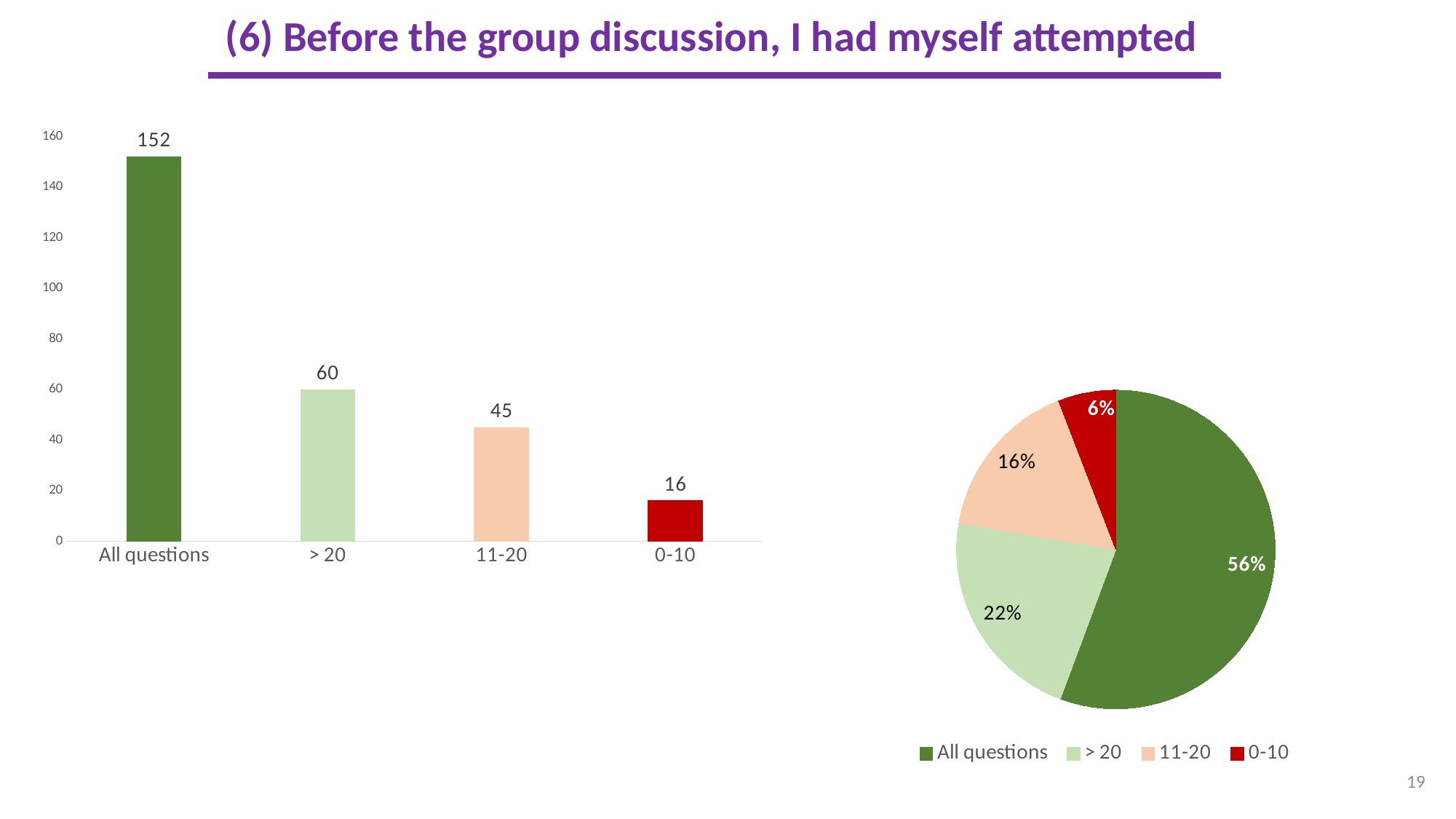
In the bar chart on the left, what is the difference between the values for '> 20' and '0-10'? 44 In the bar chart on the left, is the value for 'All questions' greater or less than 140? greater In the pie chart on the right, what share does the '0-10' slice have? 6% In the bar chart on the left, what is the value for 'All questions'? 152 In the bar chart on the left, what is the value for '11-20'? 45 How many categories are shown in the bar chart on the left? 4 In the pie chart on the right, what share does the '> 20' slice have? 22% What kind of chart is on the left side of the slide? Bar chart How many entries does the legend of the pie chart on the right list? 4 In the bar chart on the left, which category has the highest value? All questions In the bar chart on the left, which category has the lowest value? 0-10 In the bar chart on the left, which is larger: the value for '> 20' or the value for '11-20'? > 20